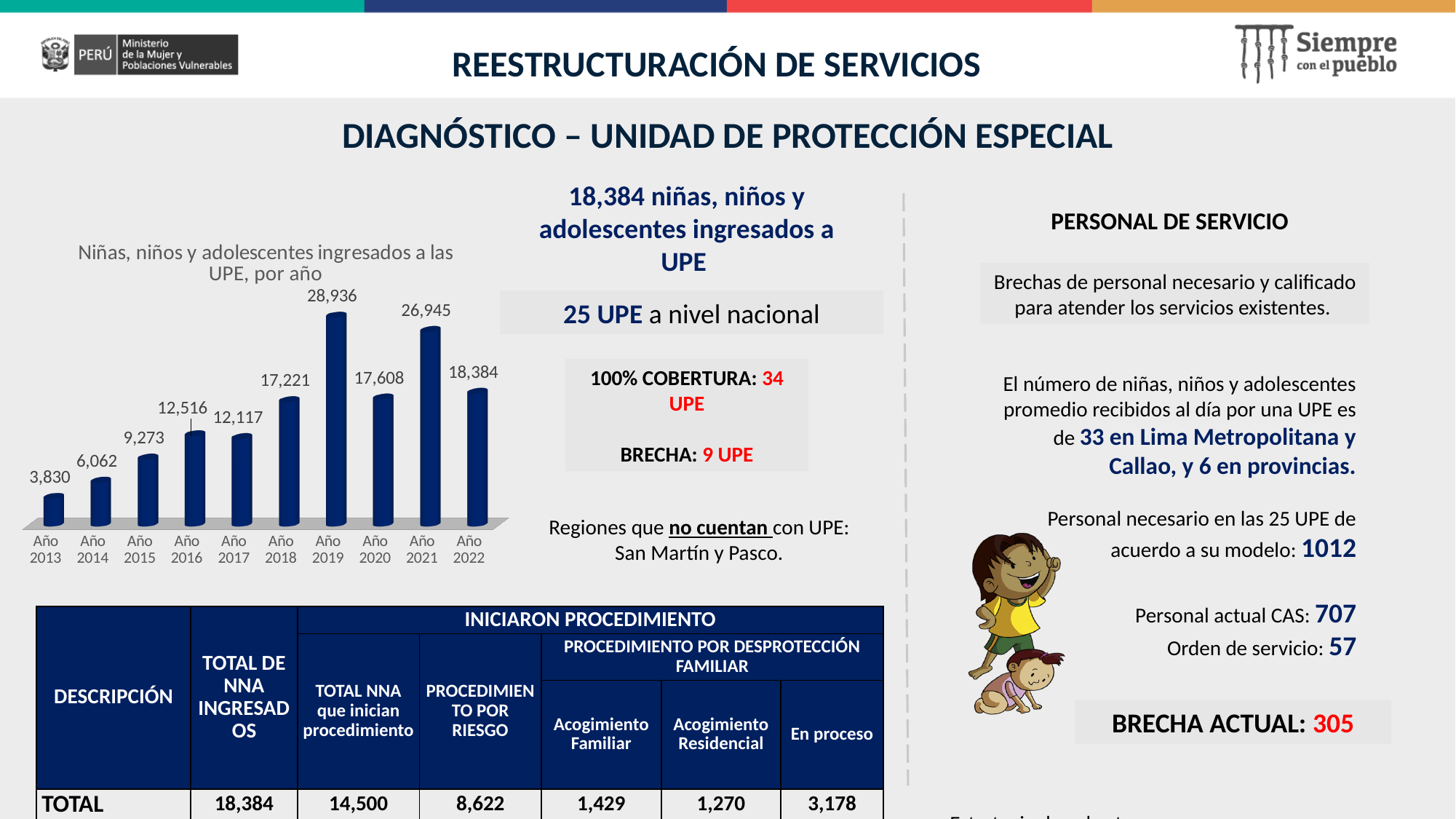
What is the value for Año 2013 in the chart? 3,830 Do the values in the chart rise or fall from Año 2013 to Año 2016? Rise What is the title of the chart on the slide? Niñas, niños y adolescentes ingresados a las UPE, por año Which is larger in the chart, the value for Año 2018 or the value for Año 2020? Año 2020 What kind of chart is shown on the slide? Bar chart Which year has the lowest value in the chart? Año 2013 What is the value for Año 2022 in the chart? 18,384 What is the value for Año 2019 in the chart 'Niñas, niños y adolescentes ingresados a las UPE, por año'? 28,936 What is the difference between the values for Año 2016 and Año 2017 in the chart? 399 How many years are shown in the chart? 10 What is the difference between the values for Año 2021 and Año 2022 in the chart? 8,561 Which year has the highest value in the chart? Año 2019